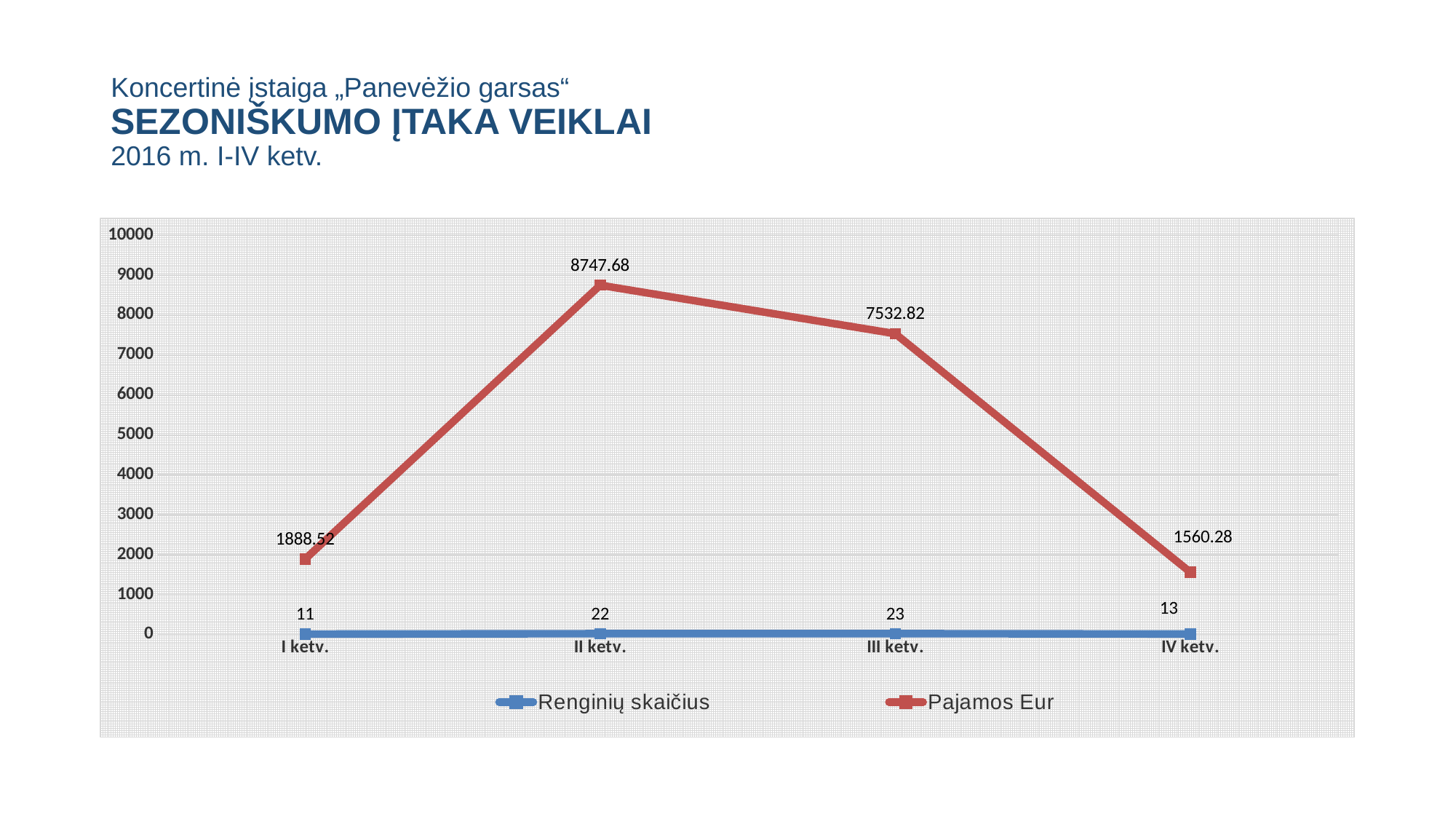
Does the Pajamos Eur series rise or fall from III ketv. to IV ketv.? Fall What is the difference between Renginių skaičius for II ketv. and I ketv.? 11 Which quarter has the lowest Renginių skaičius value? I ketv. How many quarters are shown on the x axis? 4 What is the value of Renginių skaičius for III ketv.? 23 What is the difference between Pajamos Eur for II ketv. and III ketv.? 1214.86 What is the value of Pajamos Eur for II ketv.? 8747.68 What is the value of Pajamos Eur for IV ketv.? 1560.28 How many series does the legend list? 2 What kind of chart is shown on the slide? Line chart Which quarter has the highest Pajamos Eur value? II ketv. Which is larger, Pajamos Eur for I ketv. or for IV ketv.? I ketv.